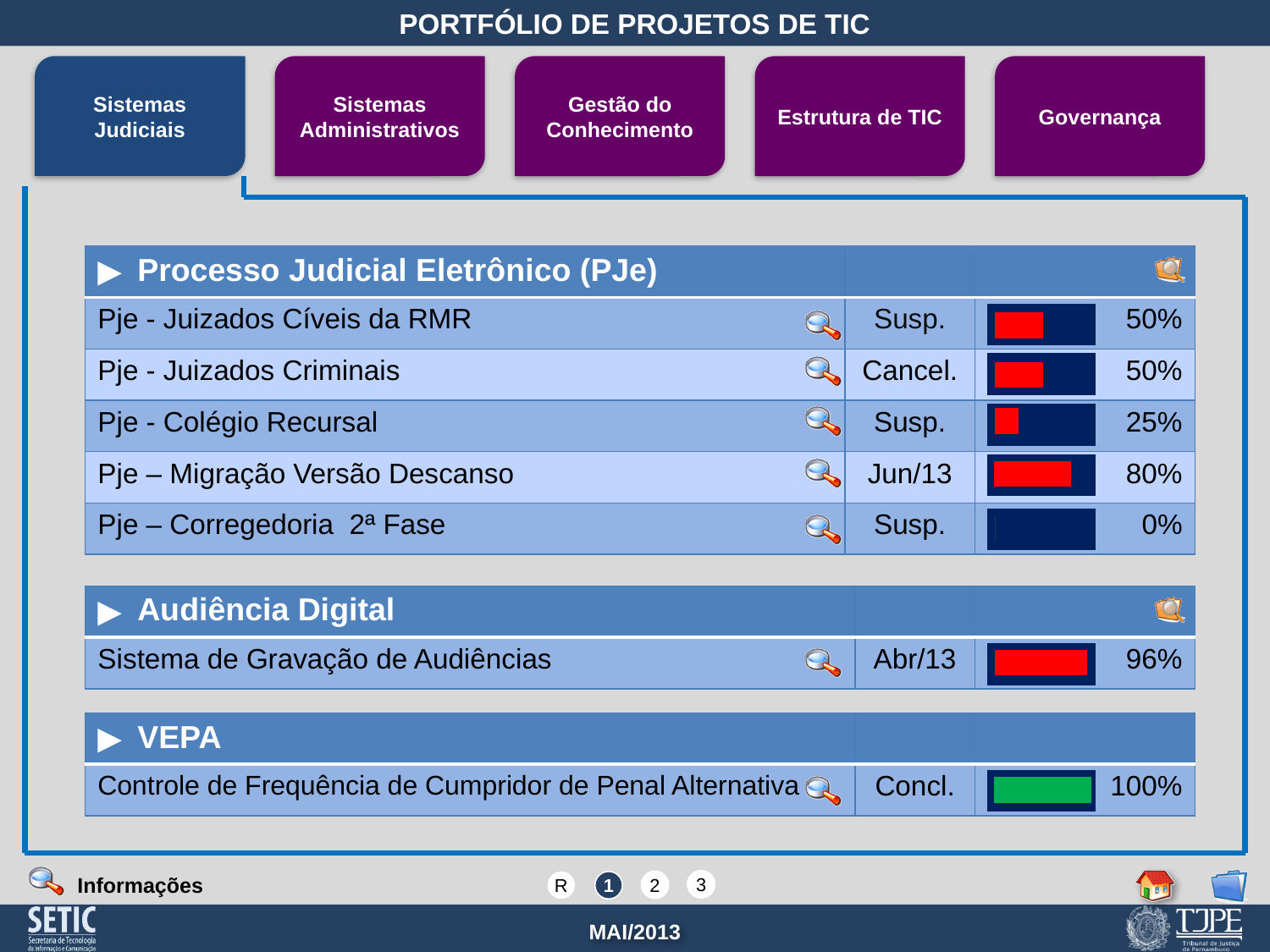
What is the progress percentage shown for Pje – Migração Versão Descanso? 80% How many projects are listed under Processo Judicial Eletrônico (PJe)? 5 What is the progress percentage shown for Sistema de Gravação de Audiências? 96% What status is shown for Pje - Juizados Criminais? Cancel. How many projects with progress bars are listed on the slide in total? 7 What is the progress percentage shown for Pje - Juizados Cíveis da RMR? 50% What colour is the progress bar for the project at 100%? Green Which has a higher progress percentage: Sistema de Gravação de Audiências or Pje – Migração Versão Descanso? Sistema de Gravação de Audiências Which project has the lowest progress percentage on the slide? Pje – Corregedoria 2ª Fase Is the progress value for Pje - Colégio Recursal greater or less than 50%? less Which project has the highest progress percentage on the slide? Controle de Frequência de Cumpridor de Penal Alternativa What is the difference in progress between Pje – Migração Versão Descanso and Pje - Colégio Recursal? 55%